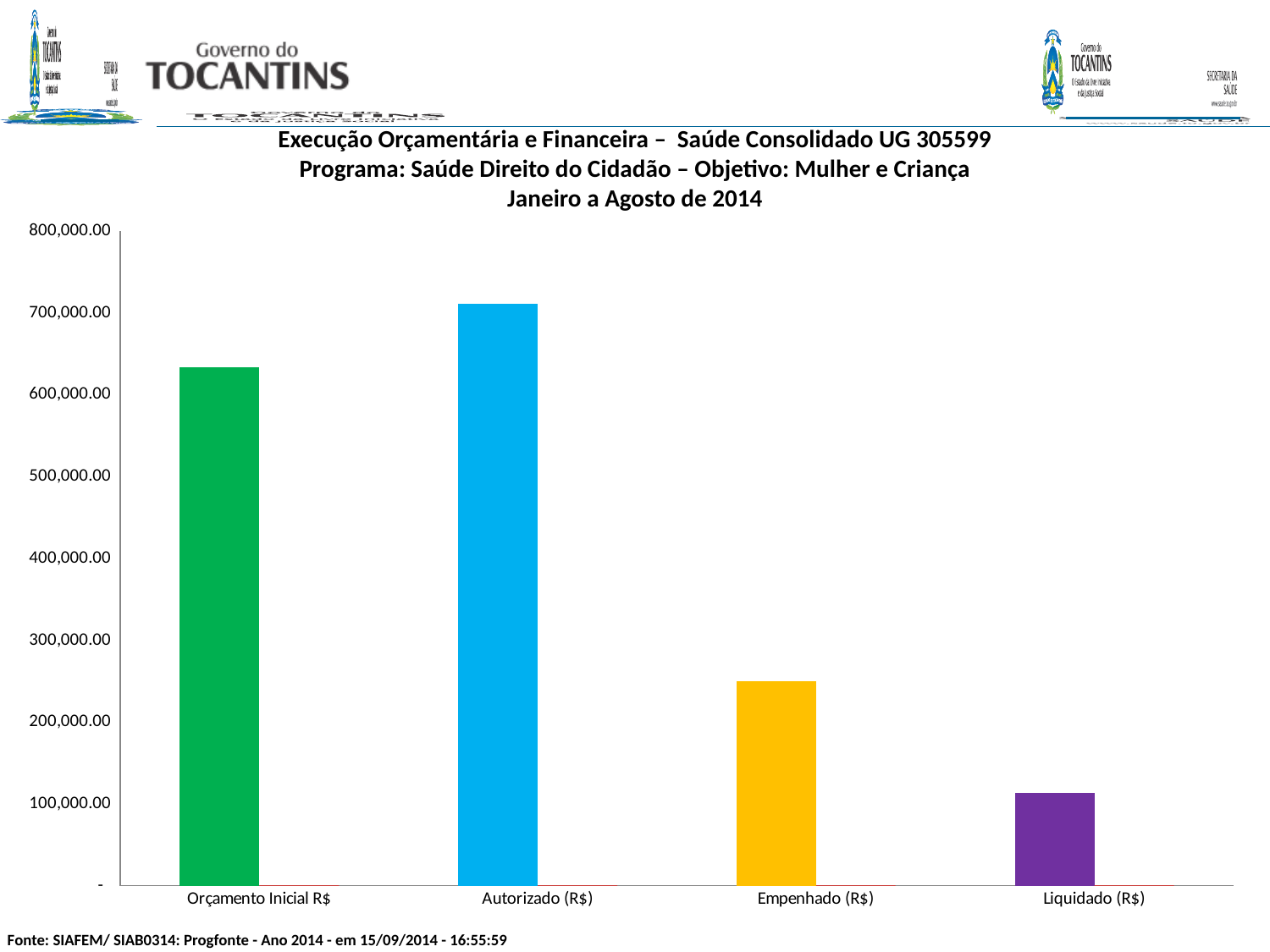
Which is larger, the value for Empenhado (R$) or the value for Liquidado (R$)? Empenhado (R$) What kind of chart is shown on the slide? bar chart Is the value for Empenhado (R$) greater or less than 200,000.00? greater Is the value for Orçamento Inicial R$ greater or less than 600,000.00? greater Do the values rise or fall from Autorizado (R$) to Liquidado (R$) along the x axis? fall Is the value for Autorizado (R$) greater or less than 800,000.00? less How many categories are shown on the x axis of the chart? 4 Which category has the lowest value? Liquidado (R$) Which category has the highest value? Autorizado (R$) Which is larger, the value for Orçamento Inicial R$ or the value for Empenhado (R$)? Orçamento Inicial R$ What period does the chart title say the data covers? Janeiro a Agosto de 2014